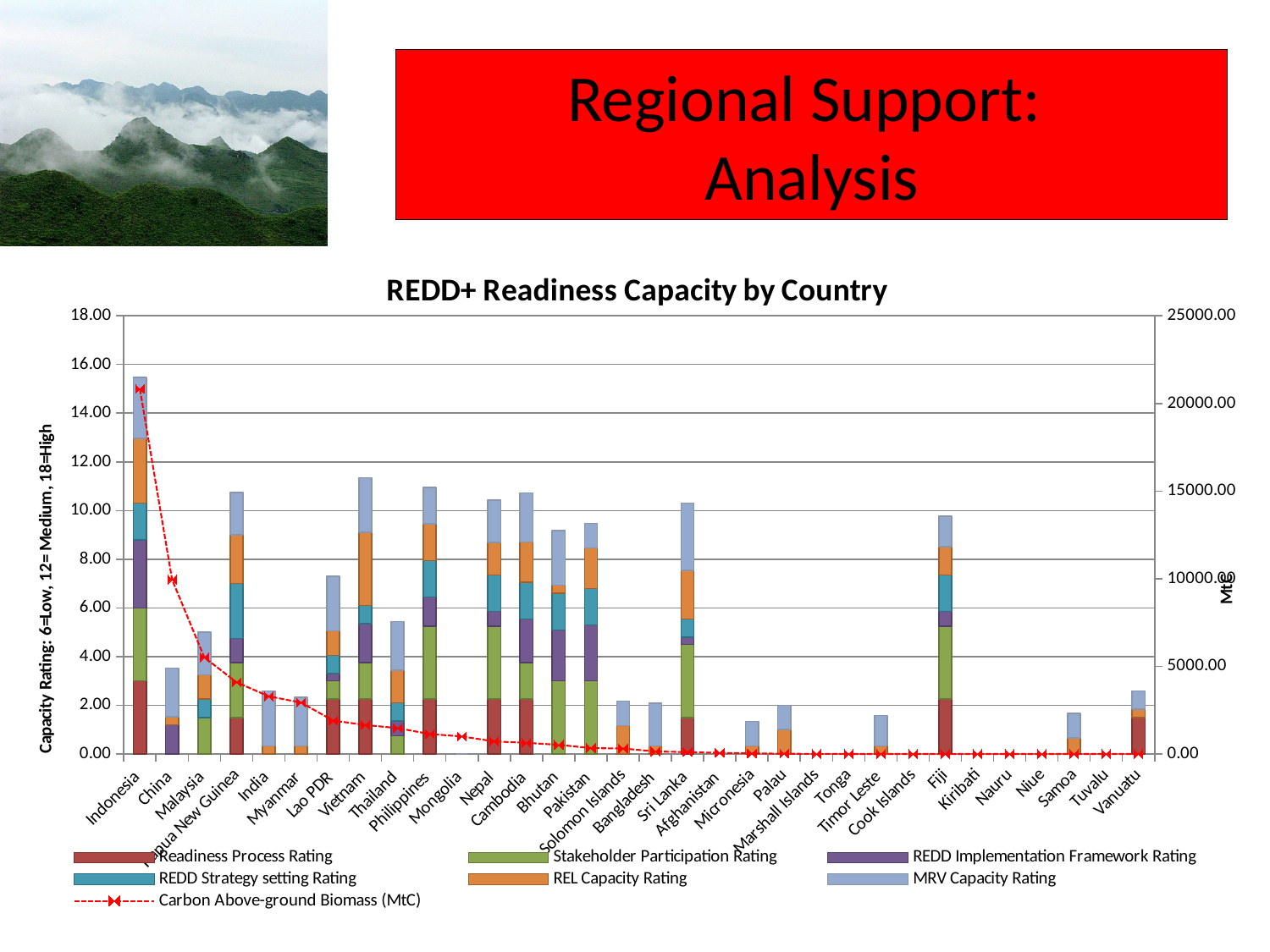
Is the total stacked capacity rating for Indonesia greater or less than 14.00? greater How many series does the chart legend list? 7 What is the title of the chart? REDD+ Readiness Capacity by Country Is the total stacked capacity rating for China greater or less than 4.00? less Which has the larger total stacked capacity rating, Fiji or Samoa? Fiji Is the total stacked capacity rating for Vietnam greater or less than 10.00? greater Does the Carbon Above-ground Biomass (MtC) line generally rise or fall from left to right across the countries? fall Which country has the highest total stacked capacity rating? Indonesia How many countries are shown along the x axis of the chart? 32 What kind of chart is shown on the slide? combination bar and line chart What is the label of the right-hand (secondary) vertical axis? MtC